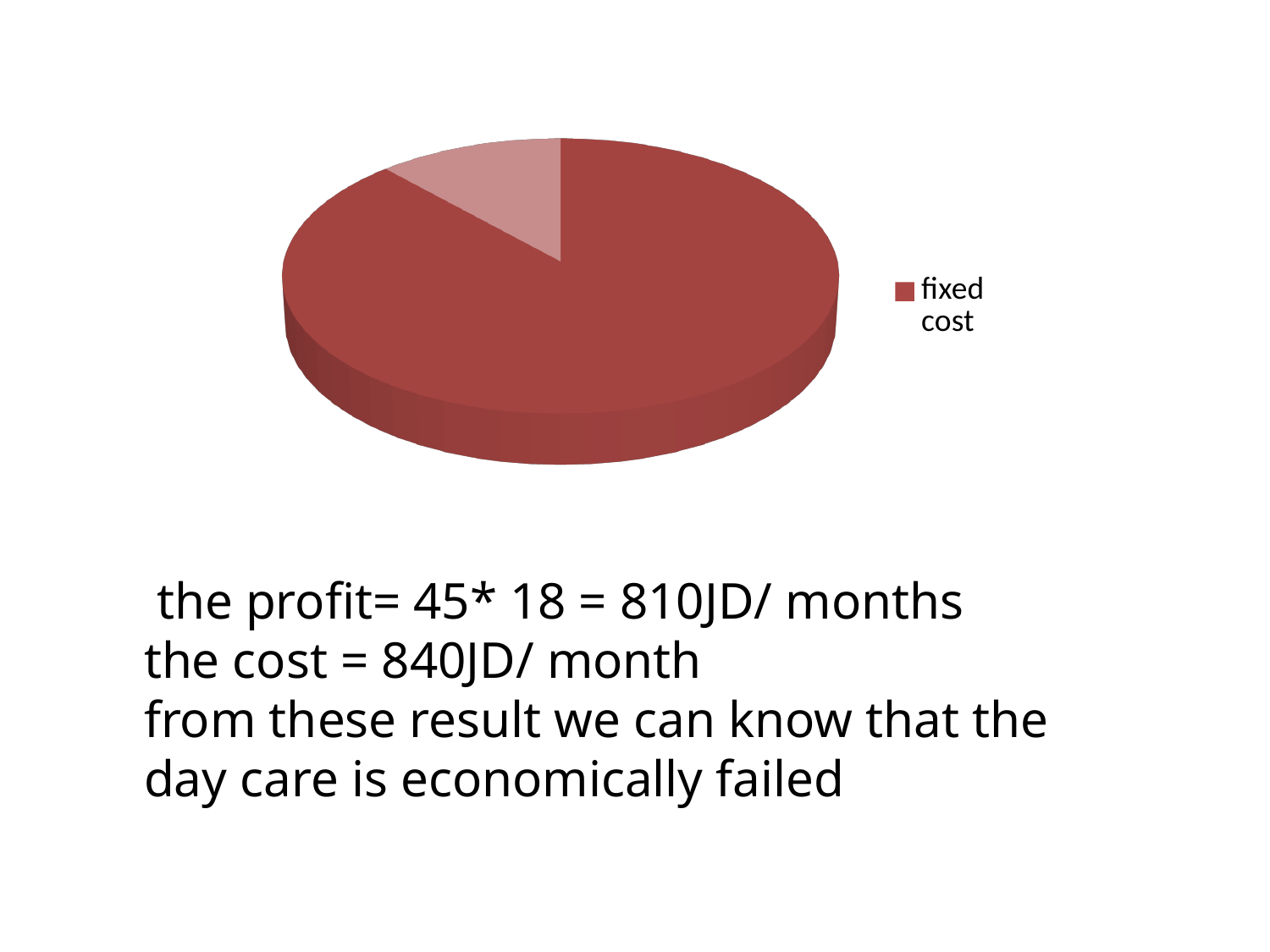
How many slices does the pie chart have? 2 Which legend entry corresponds to the largest slice of the pie? fixed cost Does the 'fixed cost' slice take up more or less than half of the pie? more How many entries does the chart's legend list? 1 What is the only entry shown in the chart's legend? fixed cost What kind of chart is shown on the slide? pie chart Which slice of the pie is larger, the dark red slice or the light pink slice? the dark red slice What colour is the slice labelled 'fixed cost' in the legend? dark red